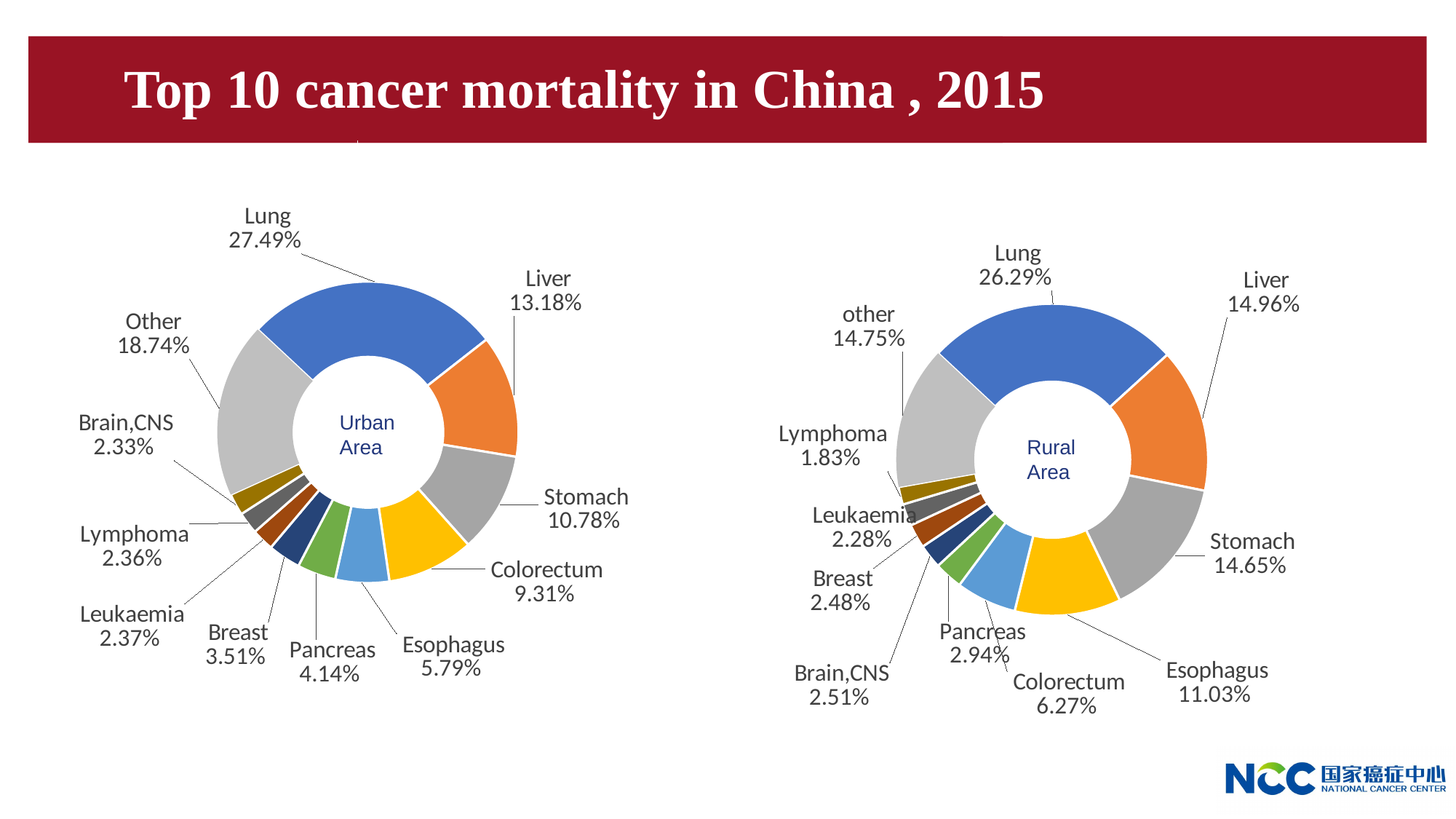
What is the difference between the Lung shares in the Urban Area chart and the Rural Area chart? 1.20% In the Rural Area chart, which is larger, the Esophagus share or the Colorectum share? Esophagus What is the title of the slide? Top 10 cancer mortality in China , 2015 In the Rural Area chart, which category has the smallest share? Lymphoma How many slices does the Urban Area chart have? 11 What kind of chart is used for the Rural Area data? Doughnut (pie) chart In the Rural Area chart, what percentage is shown for Esophagus? 11.03% In the Urban Area chart, which category has the smallest share? Brain,CNS In the Rural Area chart, what percentage is shown for Stomach? 14.65% In the Urban Area chart, what percentage is shown for Lung? 27.49% In the Urban Area chart, which cancer type has the largest share? Lung In the Urban Area chart, what is the difference between the Liver and Stomach shares? 2.40%